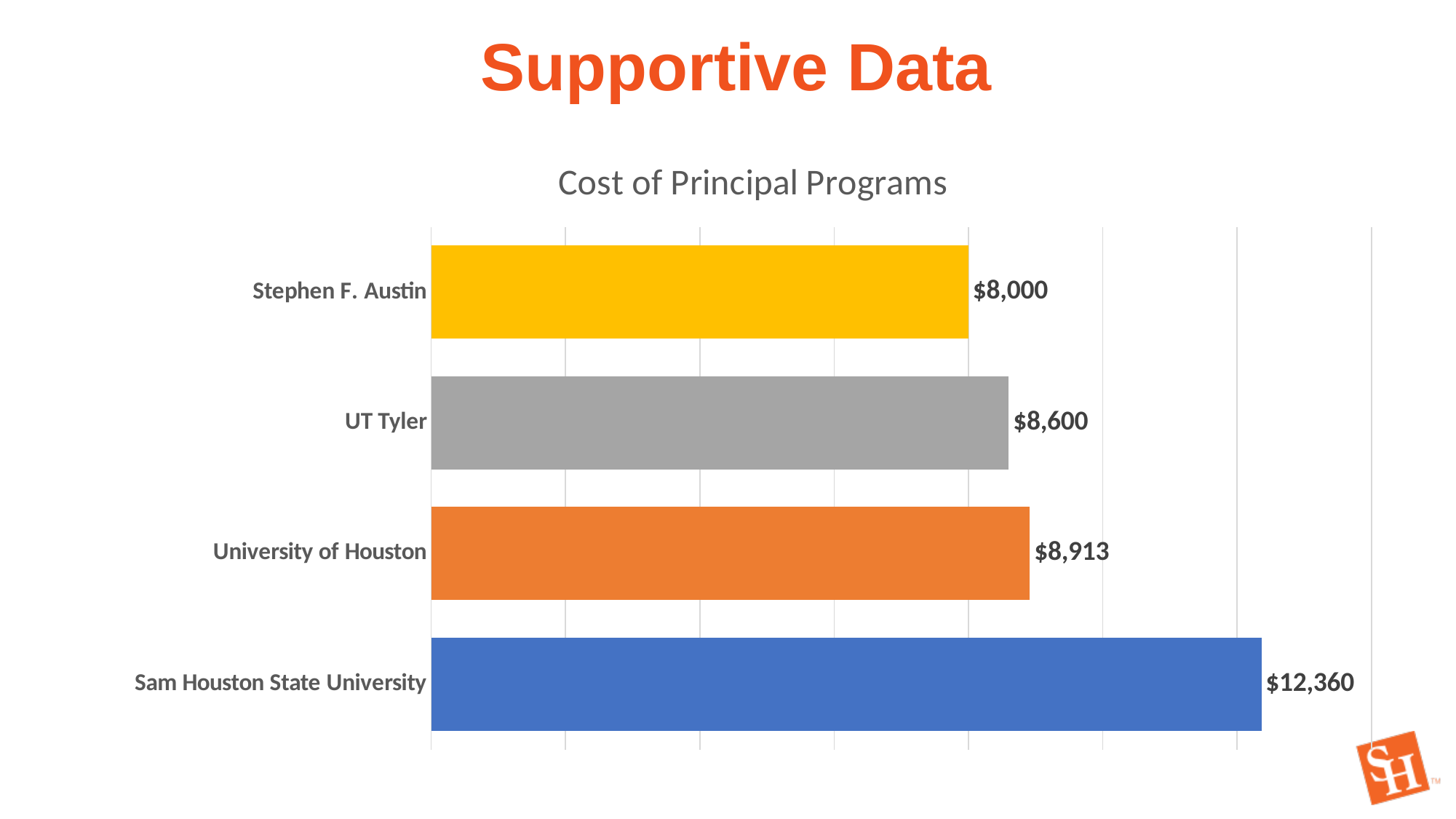
Which university has the lowest cost of principal program? Stephen F. Austin What is the cost of the principal program at Sam Houston State University? $12,360 What is the difference in cost between University of Houston and UT Tyler? $313 Which university has the highest cost of principal program? Sam Houston State University What is the cost of the principal program at University of Houston? $8,913 What is the cost of the principal program at Stephen F. Austin? $8,000 What is the title of the chart? Cost of Principal Programs What is the difference in cost between Sam Houston State University and Stephen F. Austin? $4,360 Which has a higher program cost, UT Tyler or University of Houston? University of Houston How many universities are shown in the chart? 4 What type of chart is shown on the slide? Bar chart What is the cost of the principal program at UT Tyler? $8,600